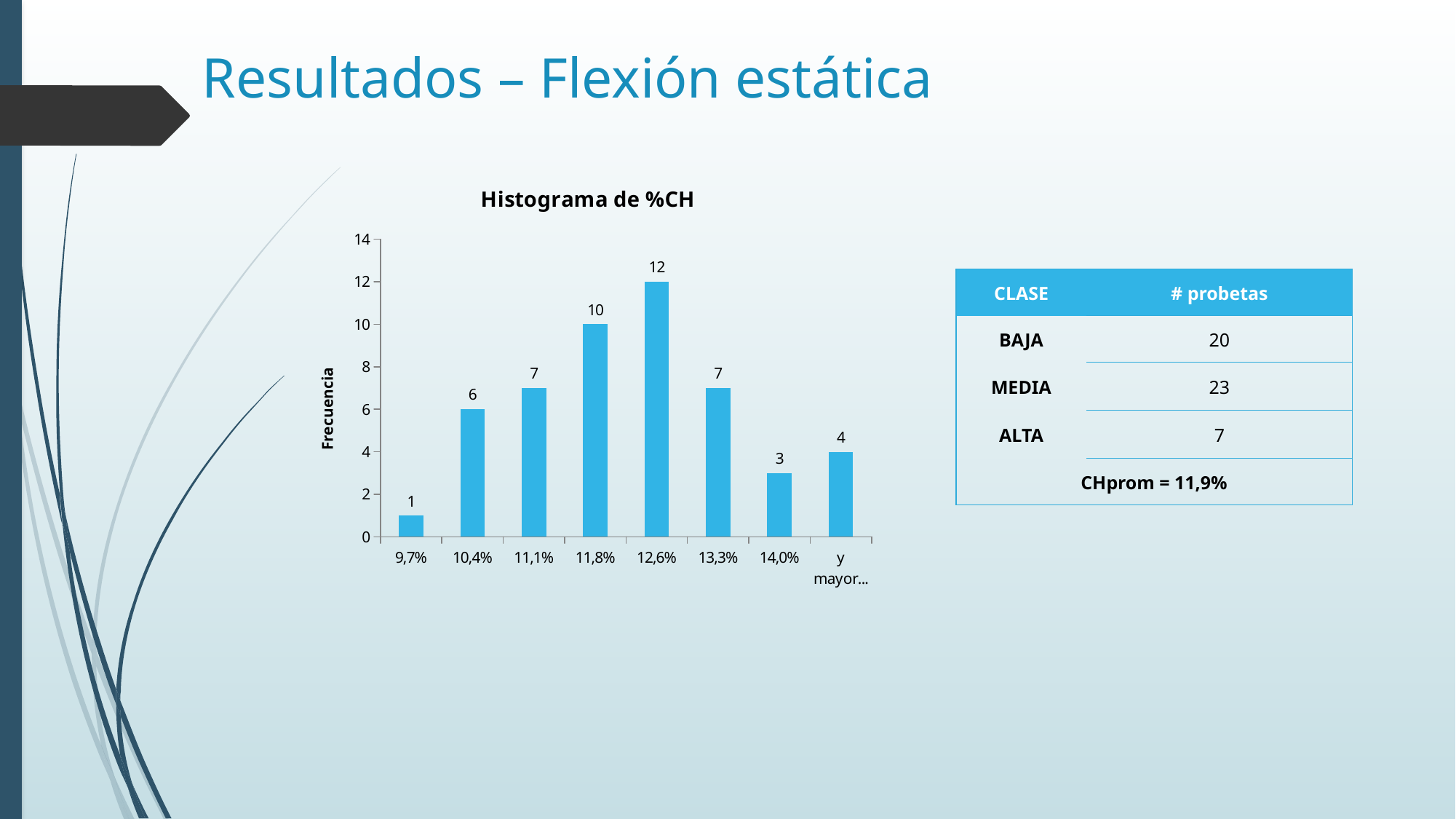
What is the frequency for the 'y mayor...' bin? 4 What is the frequency for the 10,4% bin? 6 What is the title of the chart? Histograma de %CH Which bin has the lowest frequency? 9,7% Which bin has the highest frequency? 12,6% Which has a higher frequency, the 11,1% bin or the 14,0% bin? 11,1% What is the difference in frequency between the 13,3% bin and the 14,0% bin? 4 What is the label of the y axis? Frecuencia How many bins are shown on the x axis of the histogram? 8 What is the frequency for the 12,6% bin in the Histograma de %CH chart? 12 What is the difference in frequency between the 12,6% bin and the 11,8% bin? 2 What kind of chart is shown on the slide? Bar chart